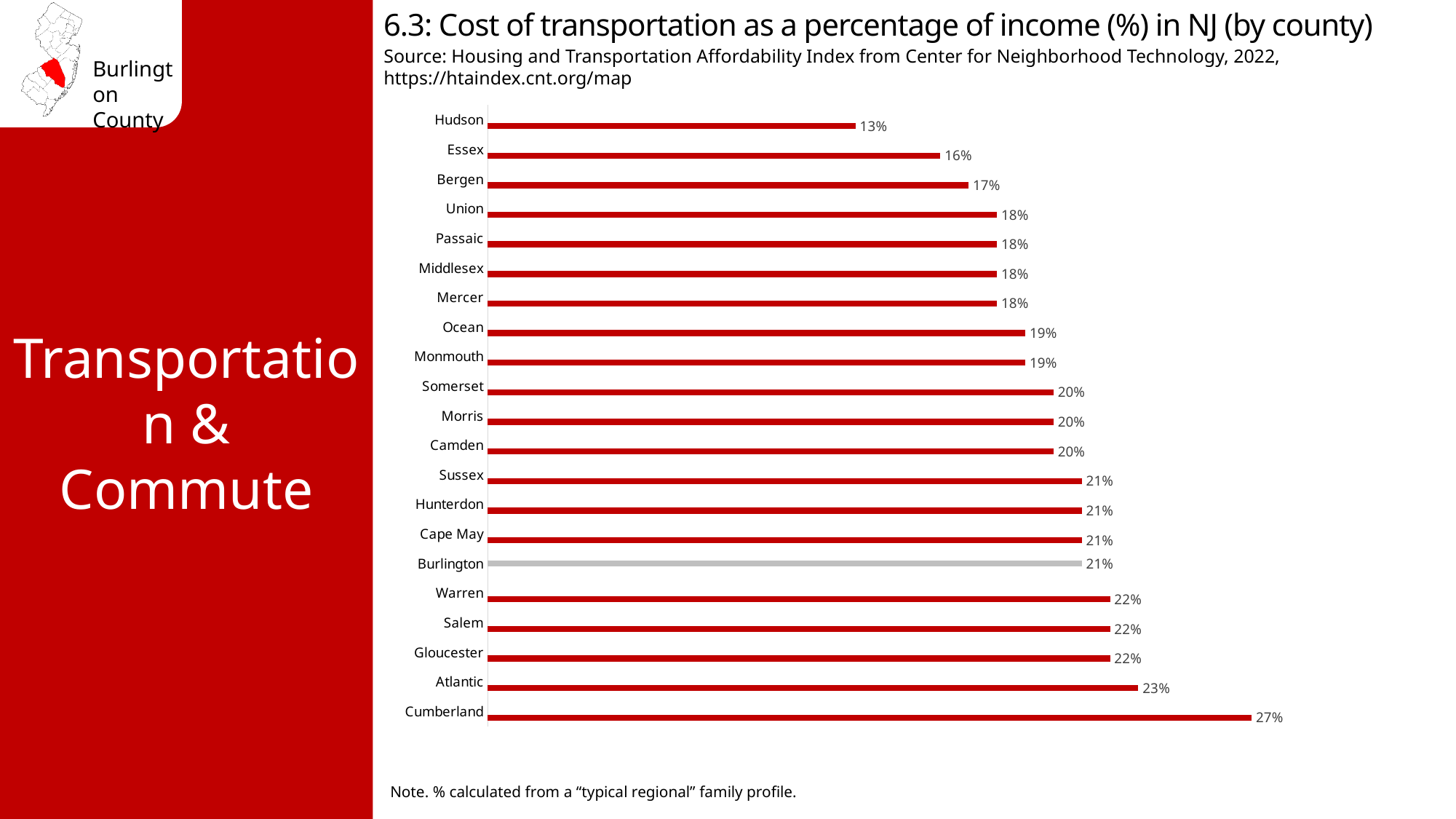
What is the cost of transportation as a percentage of income for Atlantic County? 23% Which county has the lowest cost of transportation as a percentage of income? Hudson What is the cost of transportation as a percentage of income for Hudson County? 13% What is the cost of transportation as a percentage of income for Burlington County? 21% What is the difference in percentage points between Cumberland and Hudson? 14 What kind of chart is used on this slide? Bar chart What is the value for Essex County? 16% Which county's bar is shown in grey rather than red? Burlington How many counties are shown in the chart? 21 What is the difference in percentage points between Burlington and Essex? 5 Which has a higher cost of transportation as a percentage of income, Bergen or Salem? Salem Which county has the highest cost of transportation as a percentage of income? Cumberland